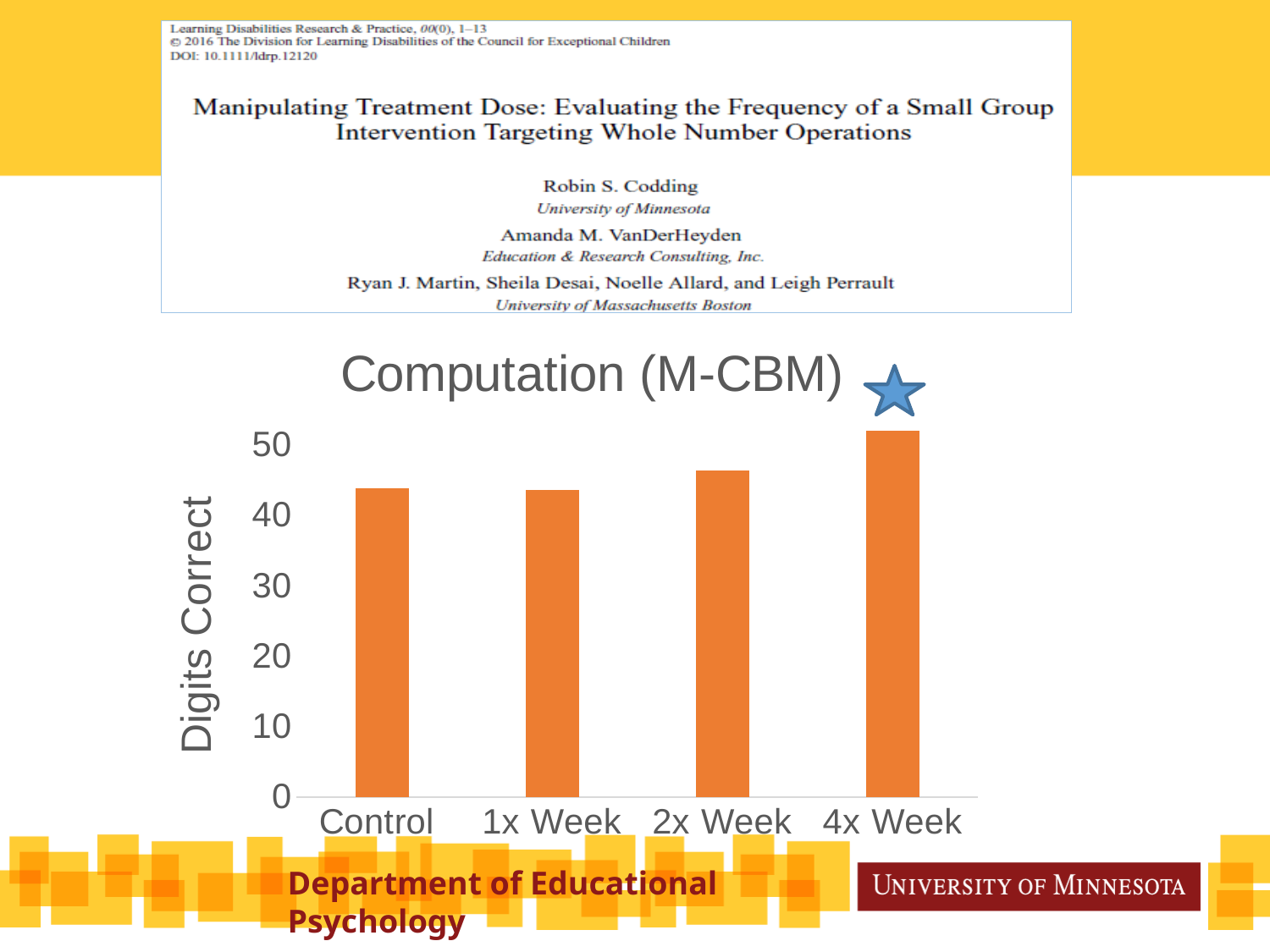
Which is larger, the value for 4x Week or the value for Control? 4x Week What kind of chart is shown on the slide? bar chart Which is larger, the value for 4x Week or the value for 2x Week? 4x Week What is the label on the vertical axis of the chart? Digits Correct Is the value for 1x Week greater or less than 40? greater Is the value for Control greater or less than 50? less Is the value for 2x Week greater or less than 40? greater How many categories are plotted on the chart? 4 Which is larger, the value for 2x Week or the value for 1x Week? 2x Week What is the title of the chart? Computation (M-CBM) Which category has the highest value on the chart? 4x Week